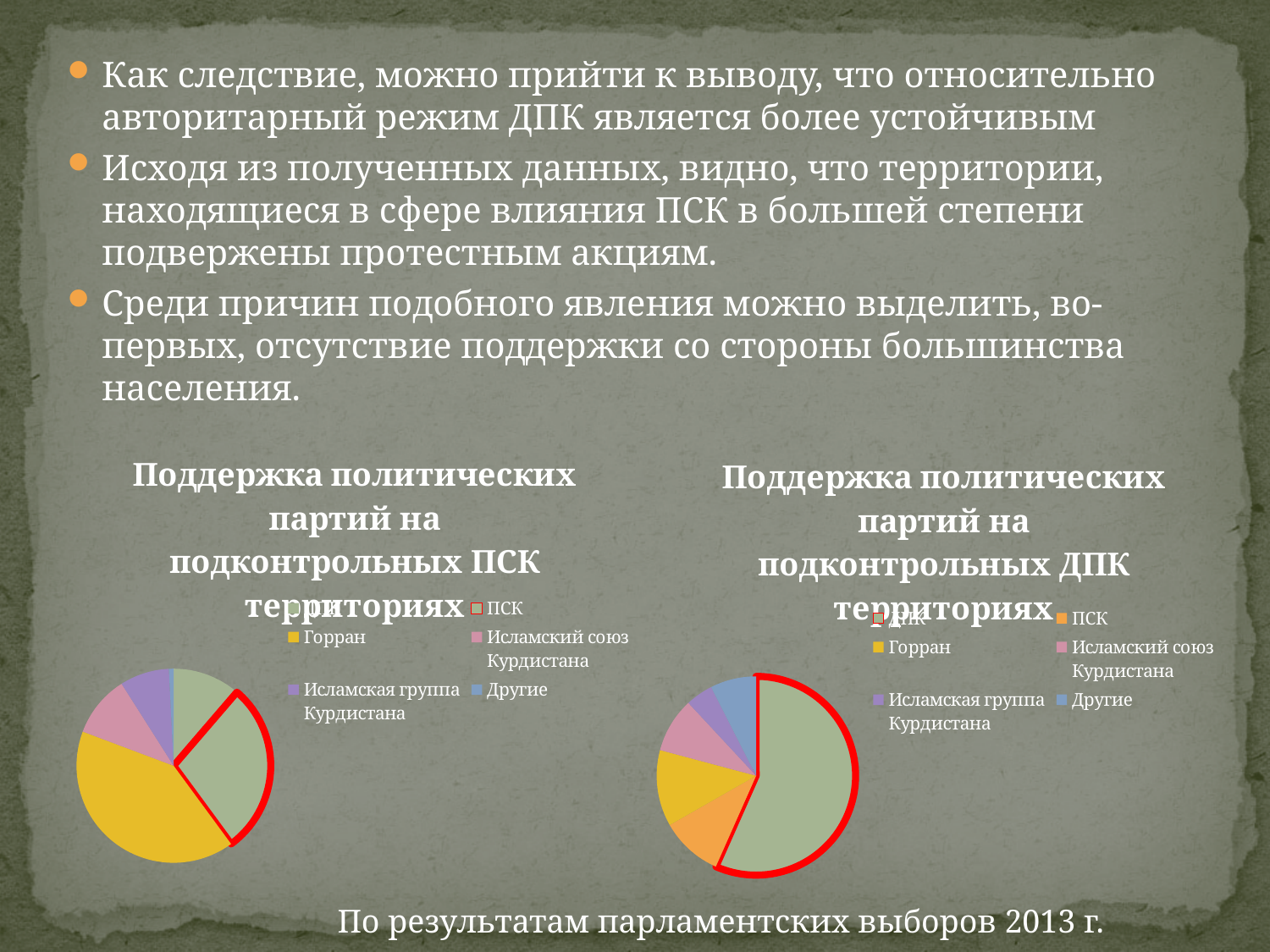
What is the title of the right chart? Поддержка политических партий на подконтрольных ДПК территориях In the right chart (ДПК territories), which slice is larger: ПСК or Исламский союз Курдистана? ПСК How many charts are shown on the slide? 2 What kind of chart is the left chart titled "Поддержка политических партий на подконтрольных ПСК территориях"? pie chart What is the title of the left chart? Поддержка политических партий на подконтрольных ПСК территориях In the right chart (ДПК territories), how many entries does the legend list? 6 In the left chart (ПСК territories), how many entries does the legend list? 6 In the right chart (ДПК territories), which party has the largest slice? ДПК What kind of chart is the right chart titled "Поддержка политических партий на подконтрольных ДПК территориях"? pie chart In the left chart (ПСК territories), which slice is larger: Горран or ПСК? Горран In the left chart (ПСК territories), which party has the largest slice? Горран In the right chart (ДПК territories), which slice is larger: ДПК or ПСК? ДПК